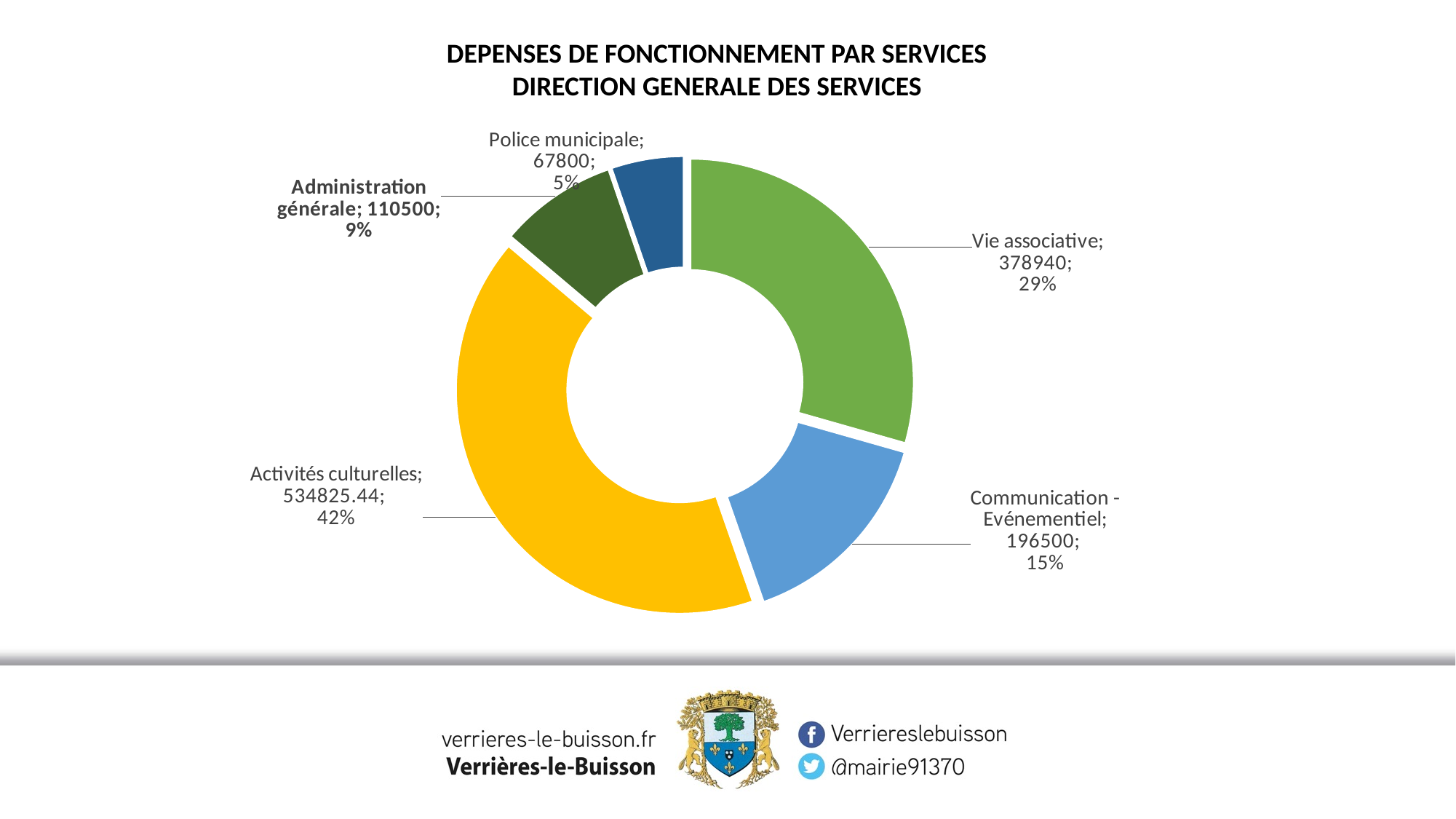
What share of the chart does Administration générale represent? 9% What kind of chart is shown on the slide? Pie chart (doughnut) How many categories are shown in the chart? 5 What is the value for Administration générale? 110500 What share of the chart does Vie associative represent? 29% What is the difference between the values for Vie associative and Communication - Evénementiel? 182440 Which category has the smallest share of the chart? Police municipale Which category has the largest share of the chart? Activités culturelles What is the value for Communication - Evénementiel? 196500 What is the value for Police municipale? 67800 What is the value for Activités culturelles? 534825.44 What is the value for Vie associative? 378940